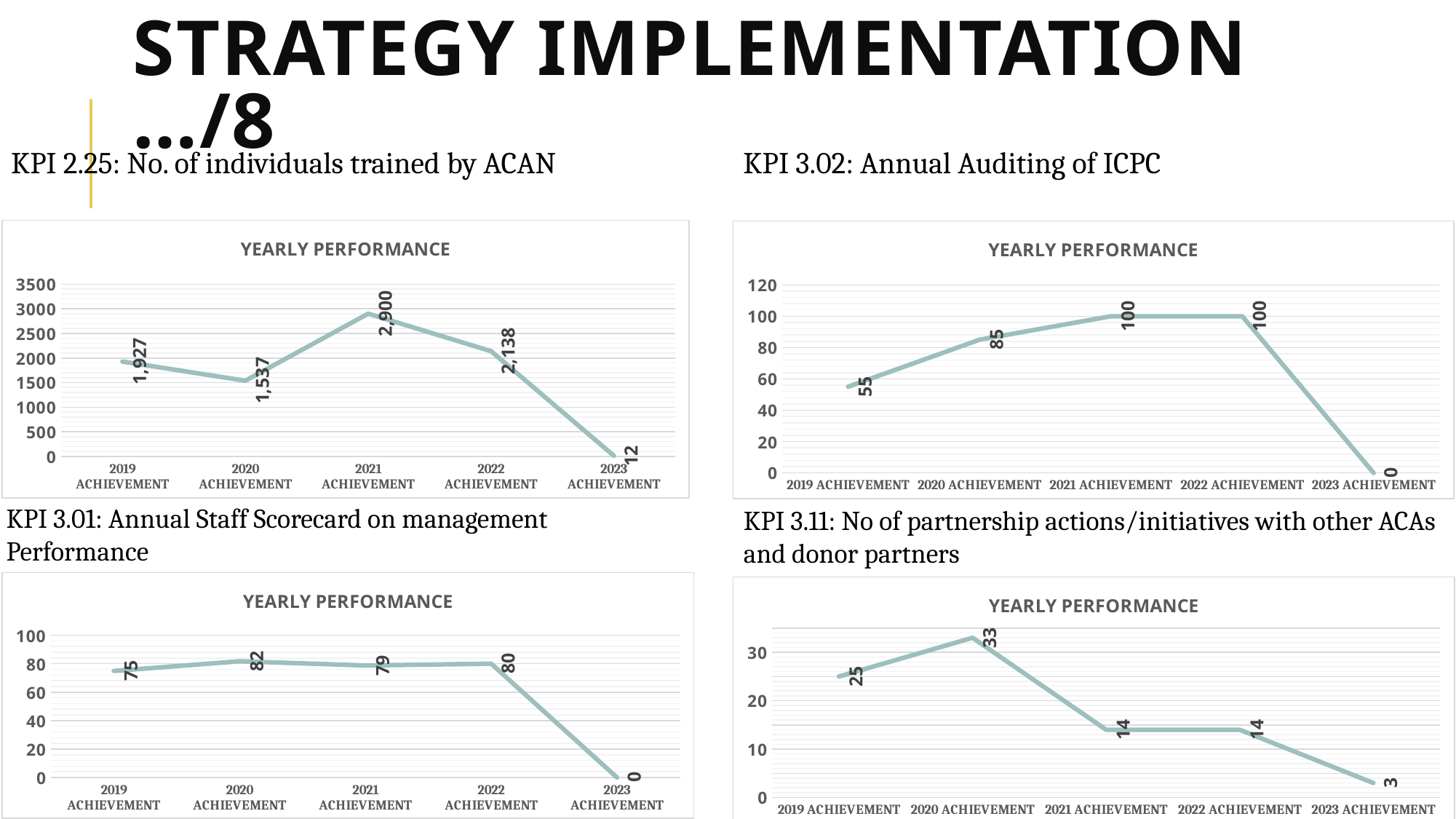
In the KPI 3.02 chart (Annual Auditing of ICPC), how many years are plotted? 5 What is the title shown inside the KPI 2.25 chart (No. of individuals trained by ACAN)? YEARLY PERFORMANCE In the KPI 2.25 chart (No. of individuals trained by ACAN), what is the value for 2021 Achievement? 2,900 In the KPI 3.11 chart (partnership actions/initiatives), what is the value for 2023 Achievement? 3 In the KPI 2.25 chart (No. of individuals trained by ACAN), which year has the lowest value? 2023 Achievement In the KPI 3.11 chart (partnership actions/initiatives), which year has the highest value? 2020 Achievement In the KPI 3.01 chart (Annual Staff Scorecard on management Performance), what is the value for 2020 Achievement? 82 In the KPI 3.02 chart (Annual Auditing of ICPC), what is the value for 2019 Achievement? 55 In the KPI 3.01 chart (Annual Staff Scorecard on management Performance), which is larger, the 2021 value or the 2022 value? 2022 Achievement What type of chart is the KPI 3.11 chart (partnership actions/initiatives)? Line chart In the KPI 2.25 chart (No. of individuals trained by ACAN), what is the difference between the 2022 and 2020 values? 601 In the KPI 3.02 chart (Annual Auditing of ICPC), what is the difference between the 2020 and 2019 values? 30